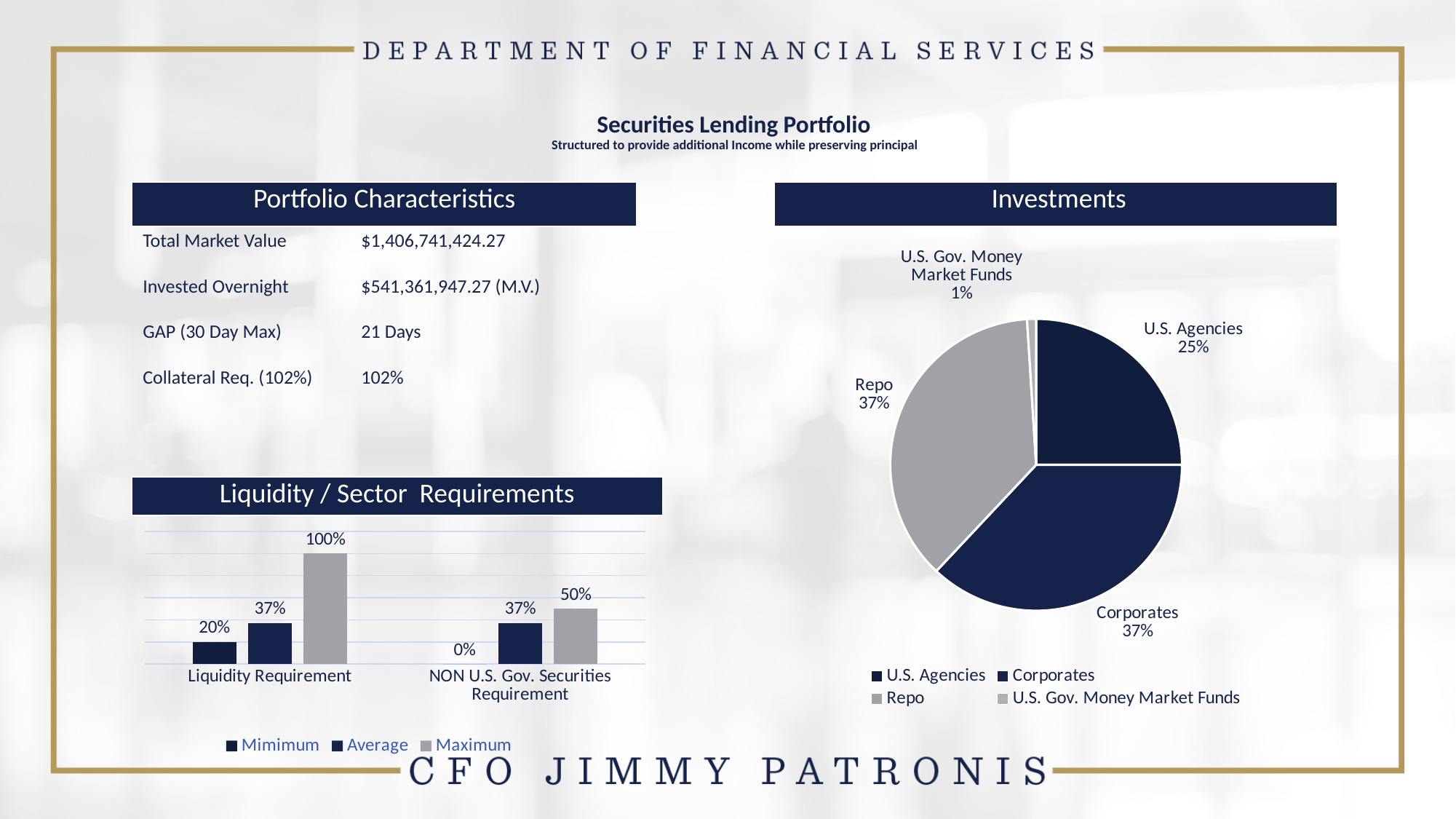
In the Investments pie chart, which category has the smallest share? U.S. Gov. Money Market Funds In the Investments pie chart, what share does Repo hold? 37% How many categories does the Investments pie chart show? 4 In the Liquidity / Sector Requirements chart, what is the Maximum value for Liquidity Requirement? 100% In the Investments pie chart, what share does U.S. Agencies hold? 25% In the Liquidity / Sector Requirements chart, what is the Average value for Liquidity Requirement? 37% In the Investments pie chart, what is the difference between the Corporates share and the U.S. Agencies share? 12% What kind of chart is the Investments chart? Pie chart How many series does the legend of the Liquidity / Sector Requirements chart list? 3 In the Liquidity / Sector Requirements chart, what is the Minimum value for NON U.S. Gov. Securities Requirement? 0% What kind of chart is the Liquidity / Sector Requirements chart? Bar chart In the Liquidity / Sector Requirements chart, which is larger: the Maximum for Liquidity Requirement or the Maximum for NON U.S. Gov. Securities Requirement? Maximum for Liquidity Requirement